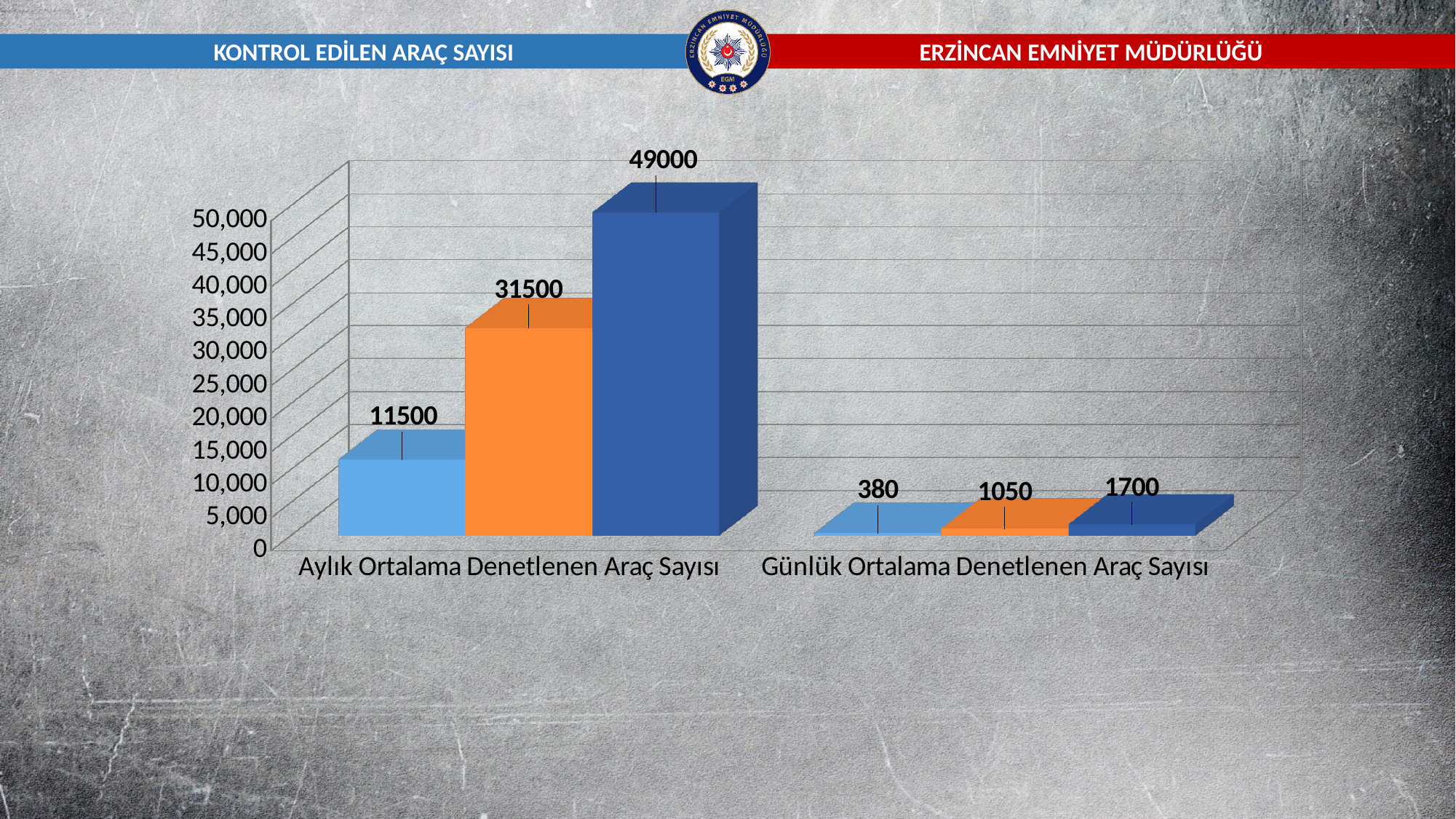
What is the value of the dark blue bar for Aylık Ortalama Denetlenen Araç Sayısı? 49000 Which bar has the lowest value in the chart? the light blue bar for Günlük Ortalama Denetlenen Araç Sayısı (380) What is the value of the light blue bar for Günlük Ortalama Denetlenen Araç Sayısı? 380 What is the value of the dark blue bar for Günlük Ortalama Denetlenen Araç Sayısı? 1700 What kind of chart is shown on the slide? bar chart What is the value of the light blue bar for Aylık Ortalama Denetlenen Araç Sayısı? 11500 What is the value of the orange bar for Aylık Ortalama Denetlenen Araç Sayısı? 31500 Which is larger for Günlük Ortalama Denetlenen Araç Sayısı: the orange bar or the light blue bar? the orange bar How many categories are shown on the x axis of the chart? 2 What is the title shown in the blue header bar at the top of the slide? KONTROL EDİLEN ARAÇ SAYISI What is the difference between the dark blue bar and the orange bar for Aylık Ortalama Denetlenen Araç Sayısı? 17500 Which bar has the highest value in the chart? the dark blue bar for Aylık Ortalama Denetlenen Araç Sayısı (49000)